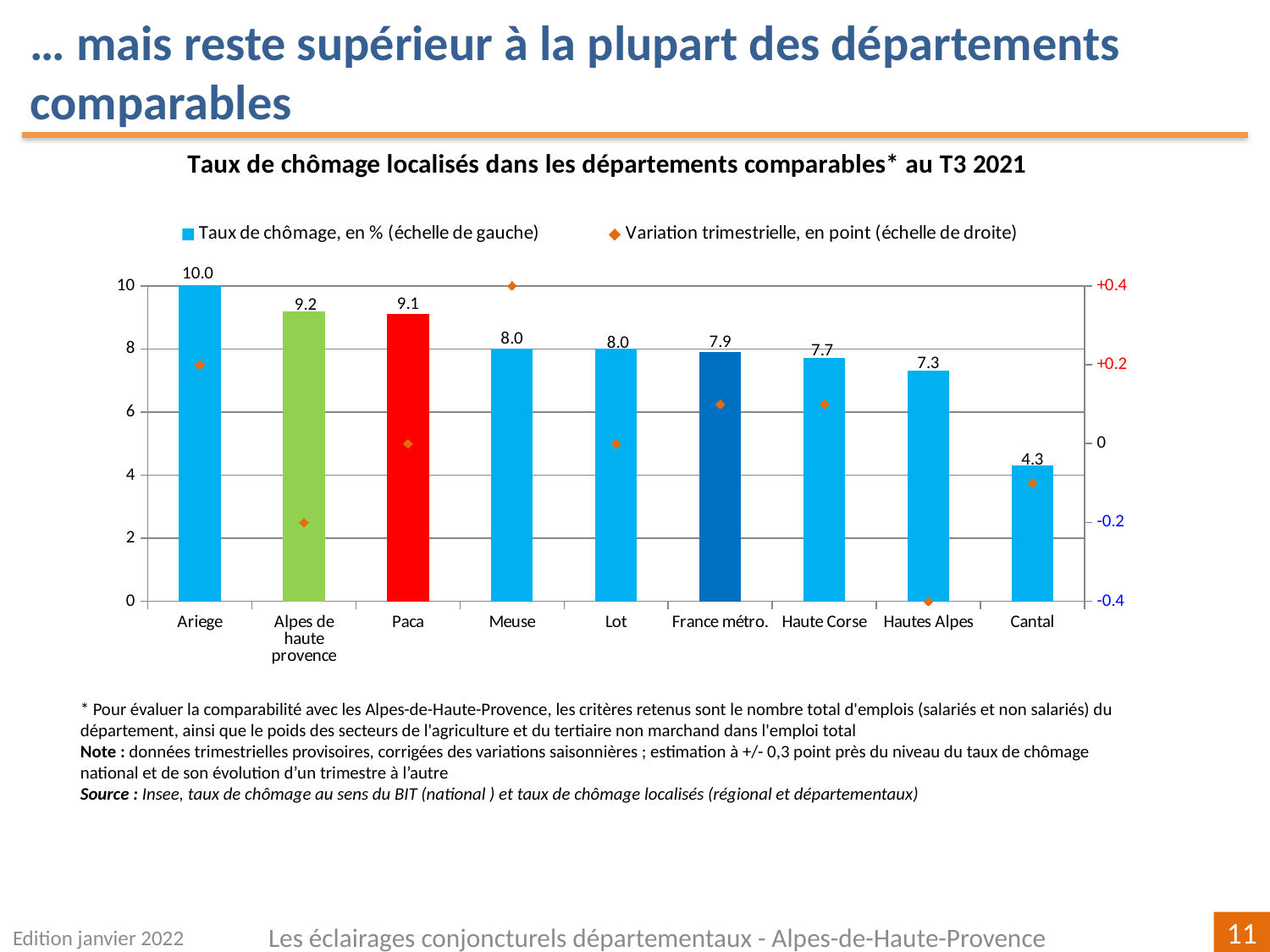
How many series does the legend list? 2 How many categories are shown on the x axis? 9 What is the unemployment rate (Taux de chômage) for Cantal? 4.3 What is the unemployment rate (Taux de chômage) for Alpes de haute provence? 9.2 Which category has the lowest unemployment rate? Cantal Which has a higher unemployment rate, Paca or Haute Corse? Paca Which category has the highest unemployment rate? Ariege What is the quarterly variation (Variation trimestrielle) for Meuse, in points? +0.4 What is the unemployment rate (Taux de chômage) for Ariege? 10.0 What is the difference between the unemployment rates of Ariege and Cantal? 5.7 What kind of chart is used for the unemployment rate series? Bar chart What is the quarterly variation (Variation trimestrielle) for Hautes Alpes, in points? -0.4